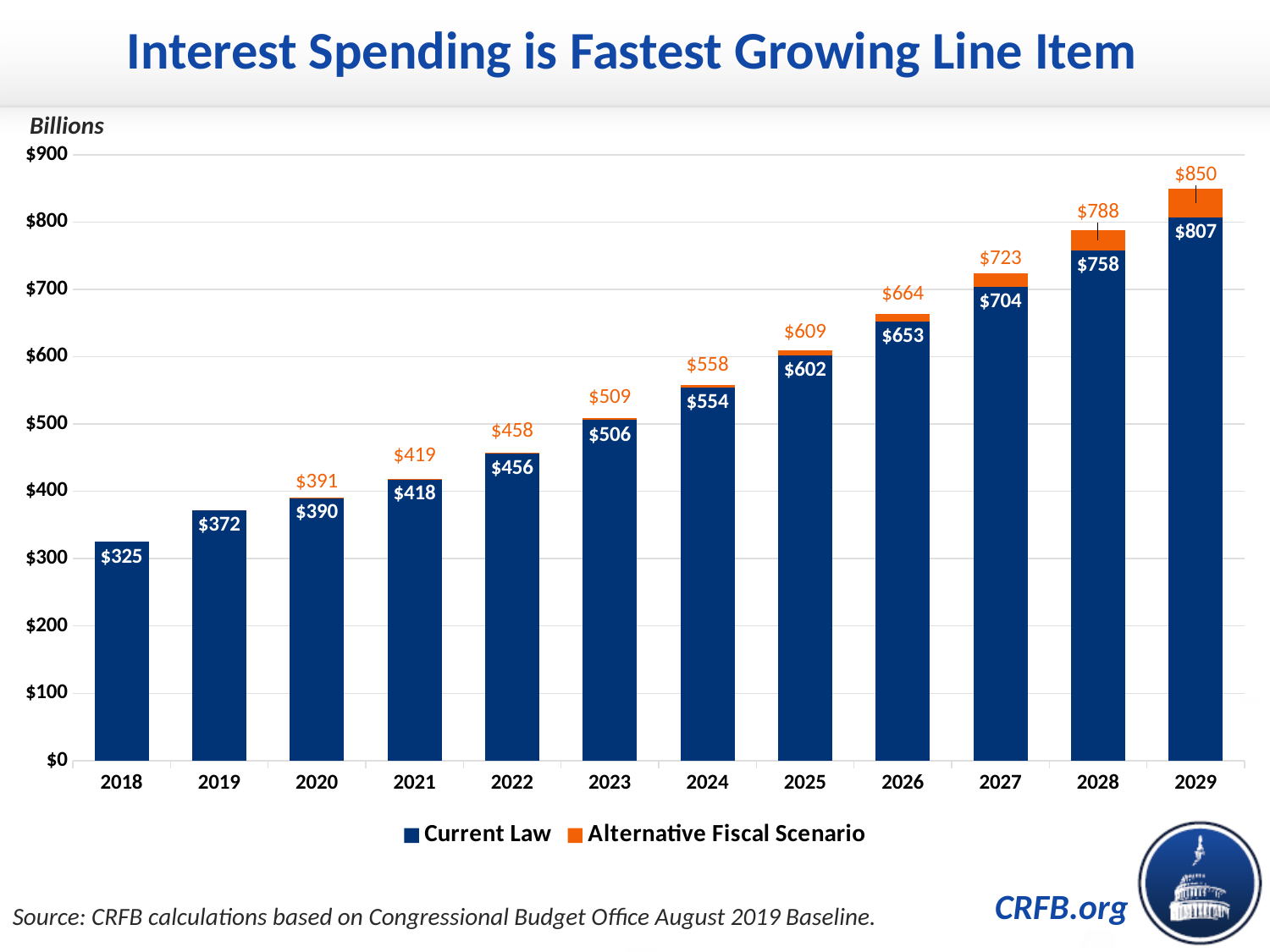
What is the Current Law value for 2025? $602 Which is larger, the Current Law value for 2024 or for 2023? 2024 How many series does the legend list? 2 Do the Current Law values rise or fall from 2018 to 2029? Rise What kind of chart is shown on the slide? Bar chart What is the Current Law value for 2018? $325 What is the difference between the Alternative Fiscal Scenario total ($850) and the Current Law value ($807) for 2029? $43 Which year has the highest Current Law value? 2029 How many years are shown on the x axis? 12 What is the difference between the Current Law values for 2029 and 2018? $482 What is the Alternative Fiscal Scenario total shown above the 2029 bar? $850 Which year has the lowest Current Law value? 2018